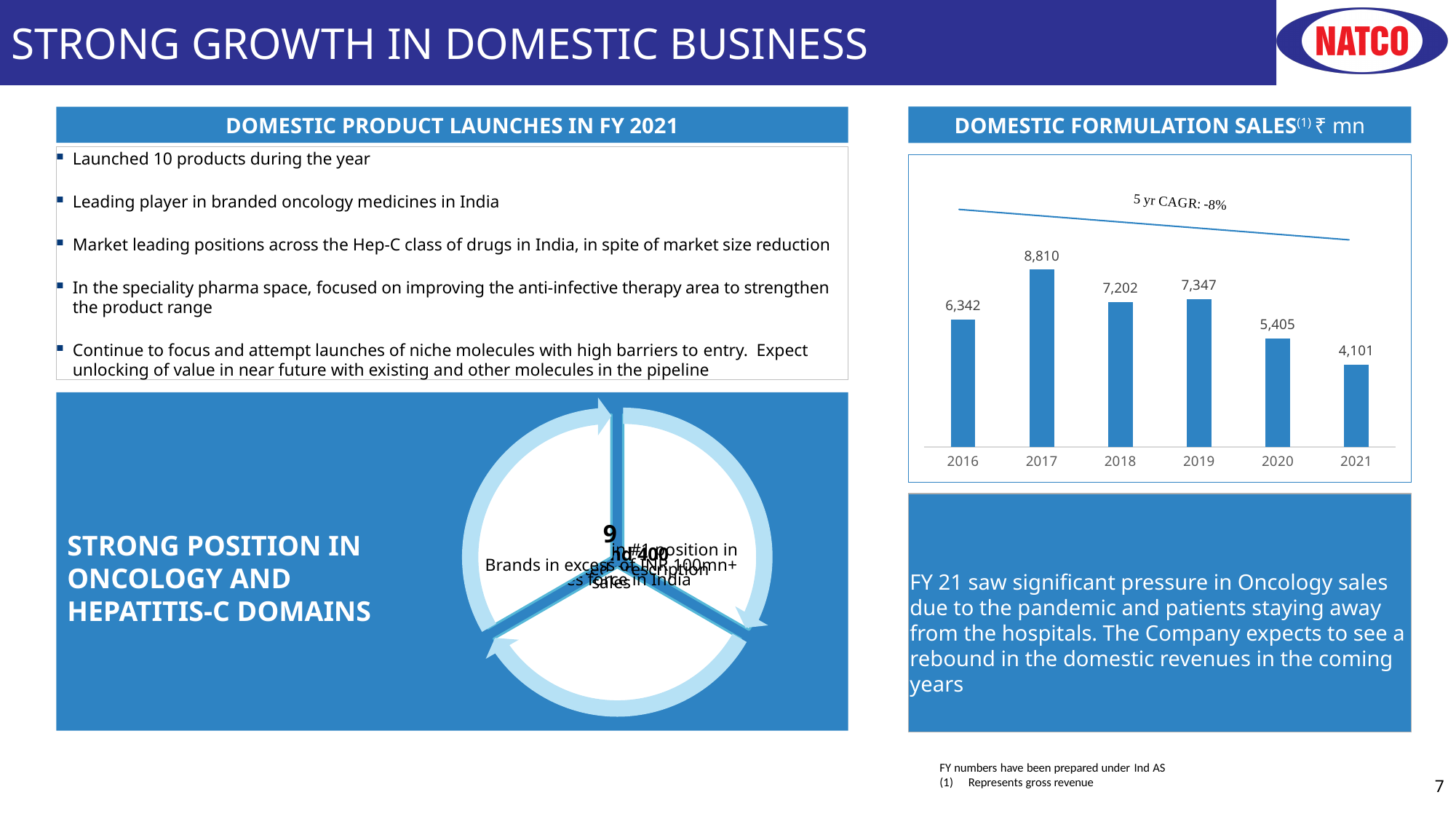
How many years are shown in the domestic formulation sales chart? 6 What type of chart is used to show domestic formulation sales? Bar chart What is the domestic formulation sales value for 2021? 4,101 What is the domestic formulation sales value for 2019? 7,347 What is the difference between domestic formulation sales in 2017 and 2021? 4,709 What is the domestic formulation sales value for 2017? 8,810 Which year had higher domestic formulation sales, 2016 or 2020? 2016 Which year has the lowest domestic formulation sales? 2021 Which year has the highest domestic formulation sales? 2017 What is the difference between domestic formulation sales in 2019 and 2020? 1,942 What 5-year CAGR is shown on the domestic formulation sales chart? -8% Do domestic formulation sales rise or fall from 2019 to 2021? Fall